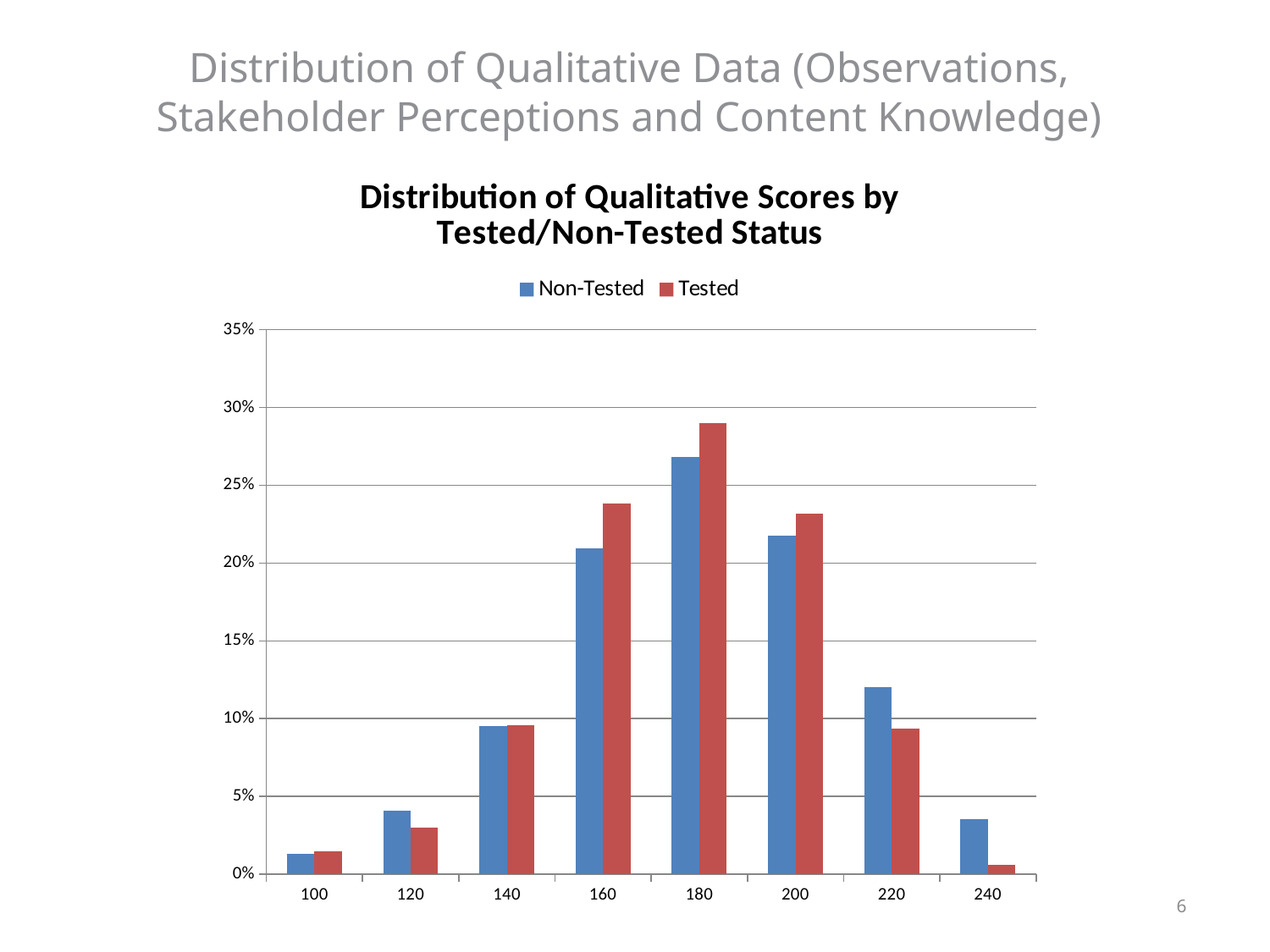
At which score is the Tested series lowest? 240 Is the Non-Tested value at 120 greater or less than 5%? less Do the Non-Tested values rise or fall from 100 to 180? rise At score 220, which series has the larger value, Non-Tested or Tested? Non-Tested At which score is the Non-Tested series lowest? 100 At score 160, which series has the larger value, Non-Tested or Tested? Tested Is the Tested value at 220 greater or less than 10%? less At which score is the Tested series highest? 180 How many score categories are shown on the x axis? 8 What kind of chart is shown on the slide? bar chart How many series does the legend list? 2 Is the Non-Tested value at 180 greater or less than 25%? greater